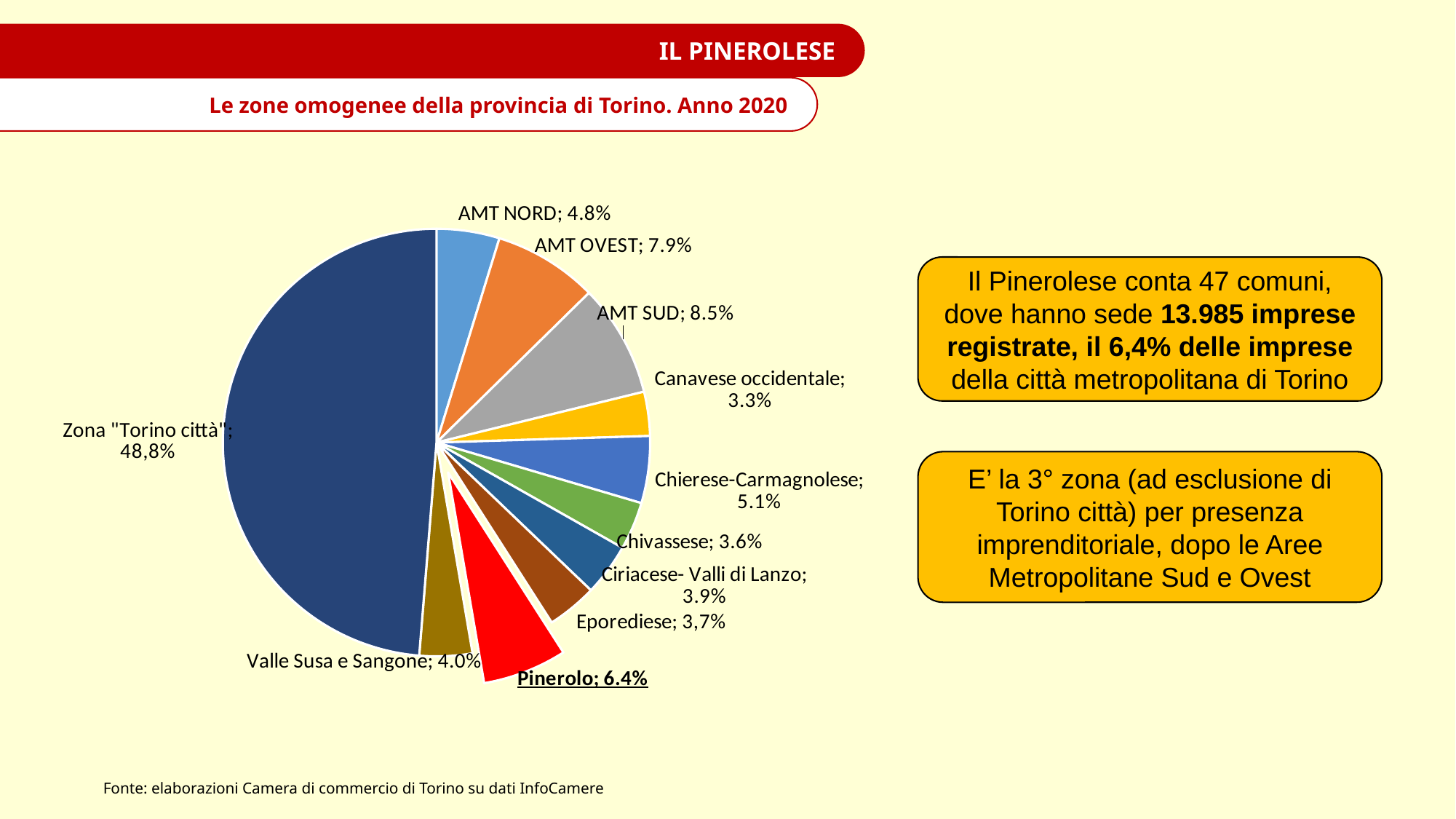
What colour is the Pinerolo slice? red What is the difference between the shares of AMT SUD and AMT OVEST? 0.6% What is the share for Zona "Torino città"? 48,8% What kind of chart is shown on the slide? pie chart Which is larger, the share for Chierese-Carmagnolese or the share for AMT NORD? Chierese-Carmagnolese Which zone has the smallest slice of the pie? Canavese occidentale What is the share for Pinerolo? 6.4% What is the title of the chart? Le zone omogenee della provincia di Torino. Anno 2020 Which zone has the largest slice of the pie? Zona "Torino città" How many slices does the pie chart have? 11 What is the share for AMT SUD? 8.5% What is the share for Canavese occidentale? 3.3%